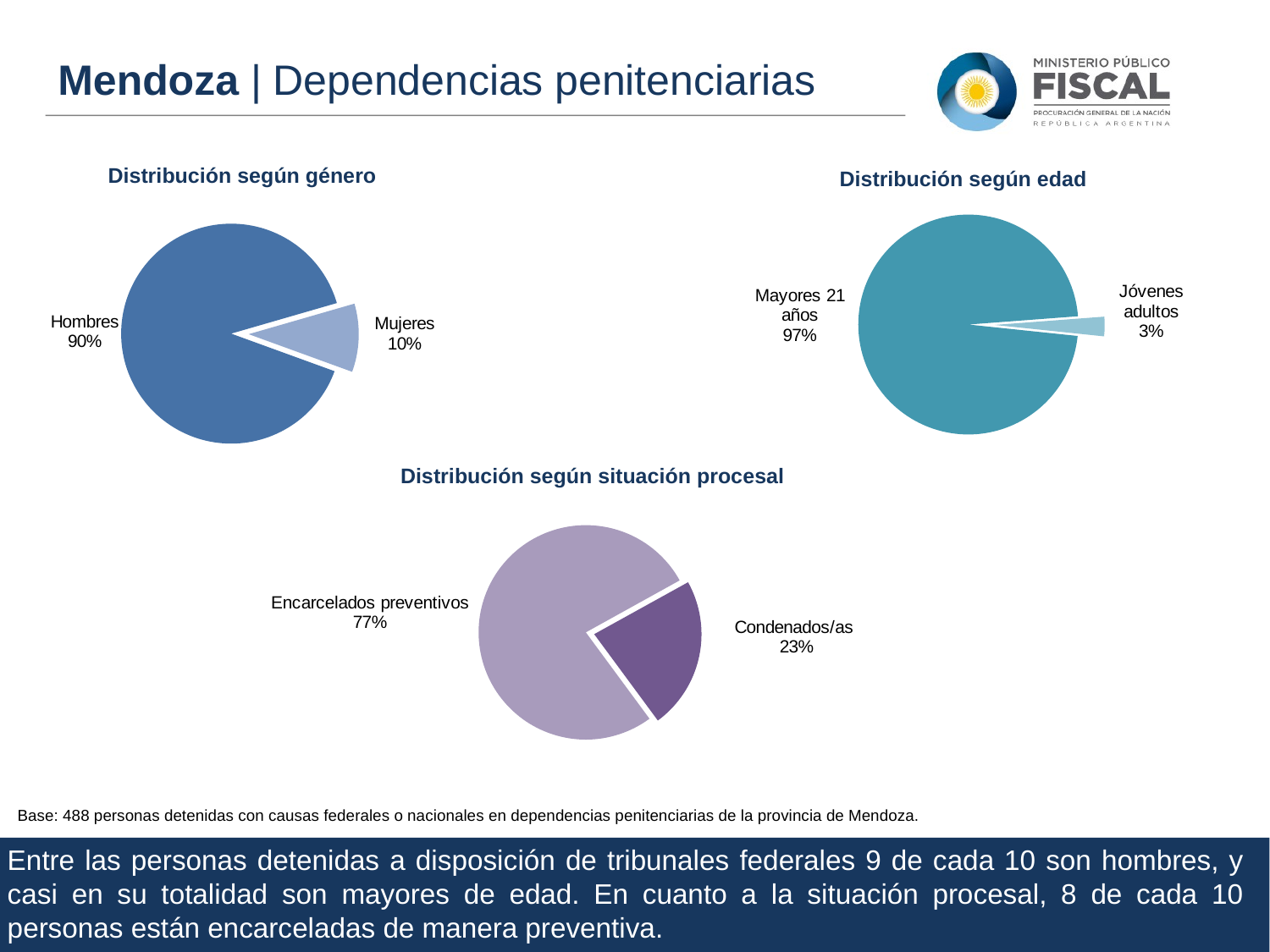
In the 'Distribución según situación procesal' chart, what share of the pie is Encarcelados preventivos? 77% In the 'Distribución según género' chart, what is the value for Mujeres? 10% In the 'Distribución según edad' chart, what share of the pie is Jóvenes adultos? 3% In the 'Distribución según género' chart, what is the difference between Hombres and Mujeres? 80% In the 'Distribución según edad' chart, what is the value for Mayores 21 años? 97% What kind of chart is 'Distribución según edad'? Pie chart In the 'Distribución según situación procesal' chart, which category is the largest? Encarcelados preventivos In the 'Distribución según edad' chart, which category is the smallest? Jóvenes adultos In the 'Distribución según situación procesal' chart, what is the difference between Encarcelados preventivos and Condenados/as? 54% How many categories does the 'Distribución según situación procesal' chart show? 2 In the 'Distribución según género' chart, what share of the pie is Hombres? 90% In the 'Distribución según situación procesal' chart, what is the value for Condenados/as? 23%